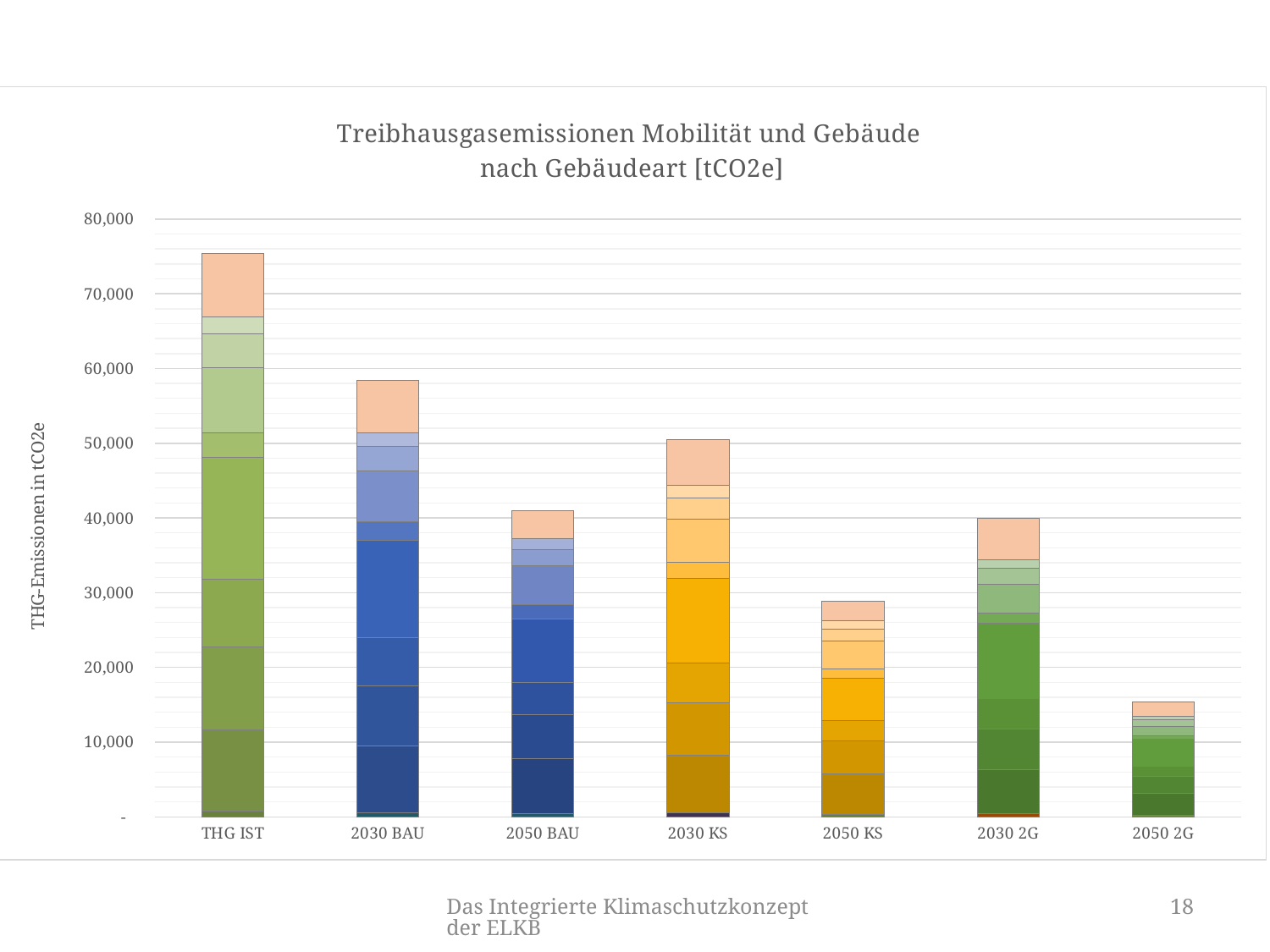
Which has the larger total bar, 2050 KS or 2050 2G? 2050 KS What is the title of the chart? Treibhausgasemissionen Mobilität und Gebäude nach Gebäudeart [tCO2e] Is the total for THG IST greater or less than 70,000? greater Which has the larger total bar, 2030 BAU or 2030 KS? 2030 BAU How many categories are shown on the x axis of the chart? 7 Which category has the highest total bar in the chart? THG IST Is the total for 2030 BAU greater or less than 60,000? less Is the total for 2050 KS greater or less than 20,000? greater Which category has the lowest total bar in the chart? 2050 2G What kind of chart is shown on the slide? Stacked bar chart